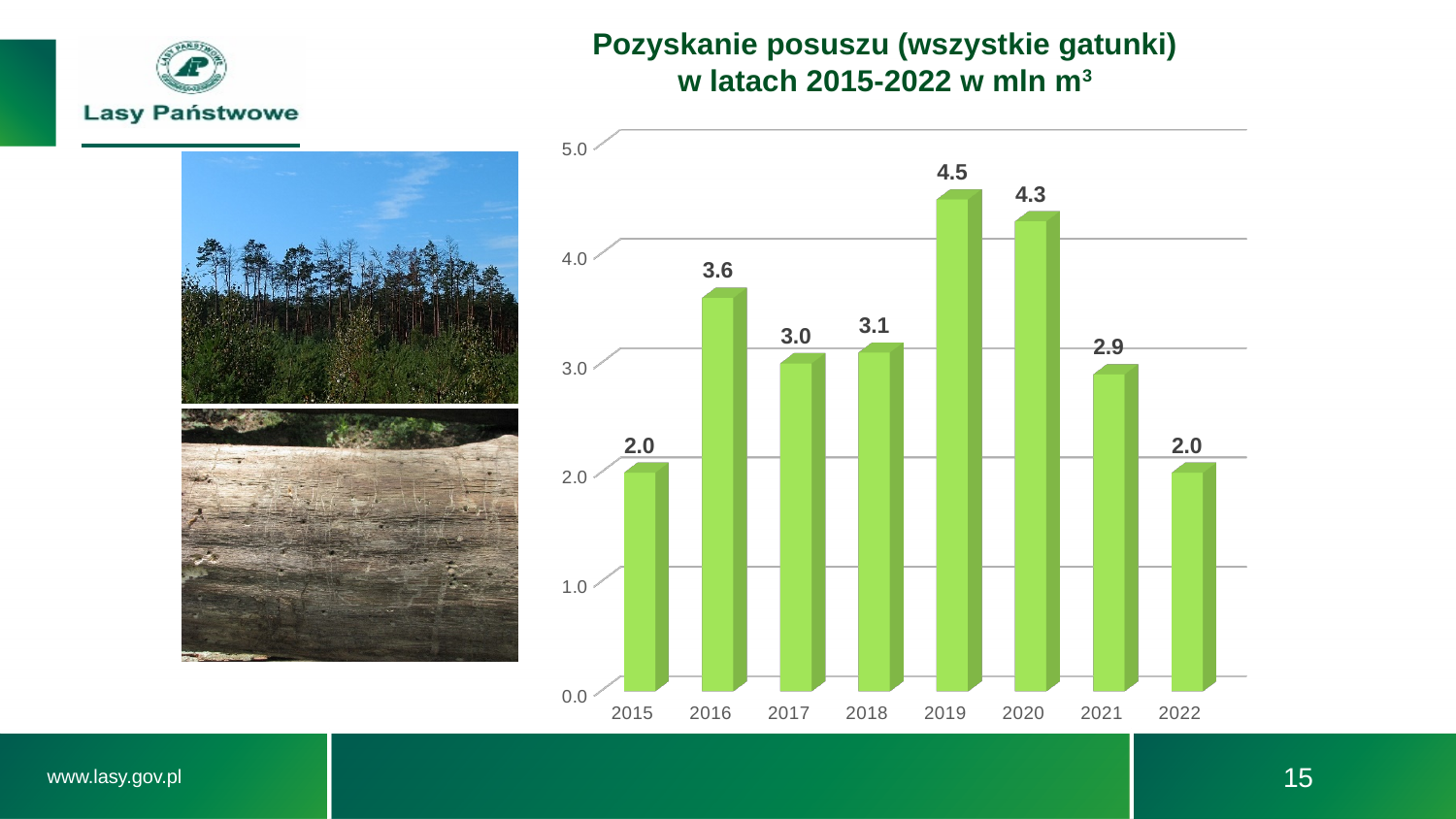
What is the value for 2016? 3.6 Which is larger, the value for 2020 or the value for 2018? 2020 Do the values rise or fall from 2019 to 2022? fall Which year has the lowest value? 2015 and 2022 Which year has the highest value? 2019 What is the difference between the values for 2016 and 2017? 0.6 What kind of chart is shown on the slide? bar chart What is the value for 2019? 4.5 What is the value for 2021? 2.9 What is the difference between the values for 2019 and 2022? 2.5 How many years are shown on the x axis? 8 Is the value for 2020 greater or less than 4.0? greater